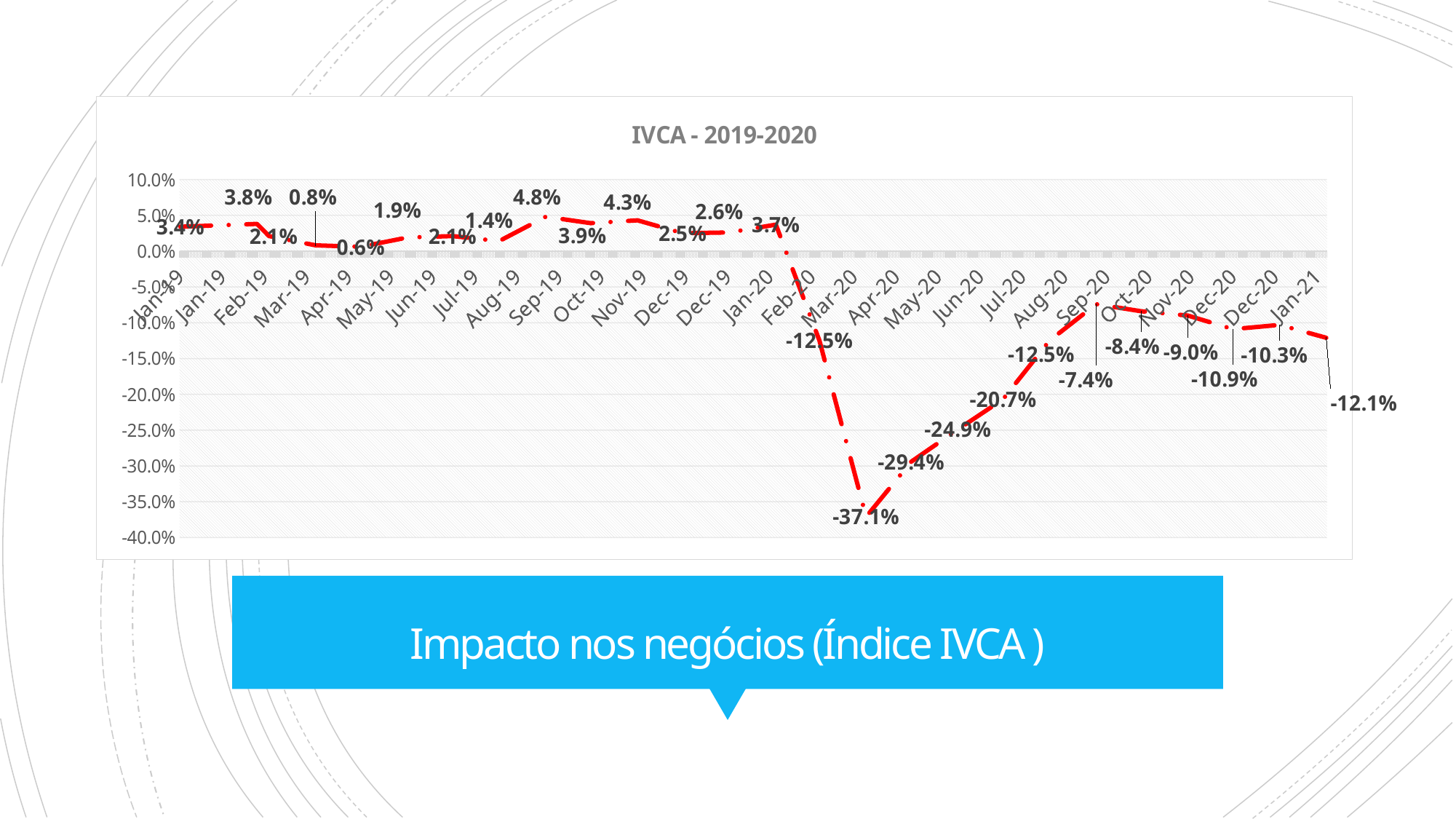
What is the value of the first data point (Jan-19)? 3.4% Is the lowest point on the line greater or less than -35.0%? less What is the value of the last data point (Jan-21)? -12.1% After reaching its lowest point of -37.1%, does the line rise or fall over the following months? Rise What is the difference between the highest labelled value (4.8%) and the lowest labelled value (-37.1%)? 41.9 percentage points What is the lowest value labelled on the line? -37.1% Which is larger, the value labelled 4.8% or the value labelled 4.3%? 4.8% What is the highest value labelled on the line? 4.8% What colour is the line in the chart? Red What is the value for Mar-19? 2.1% What is the title of the chart? IVCA - 2019-2020 What kind of chart is shown on the slide? Line chart